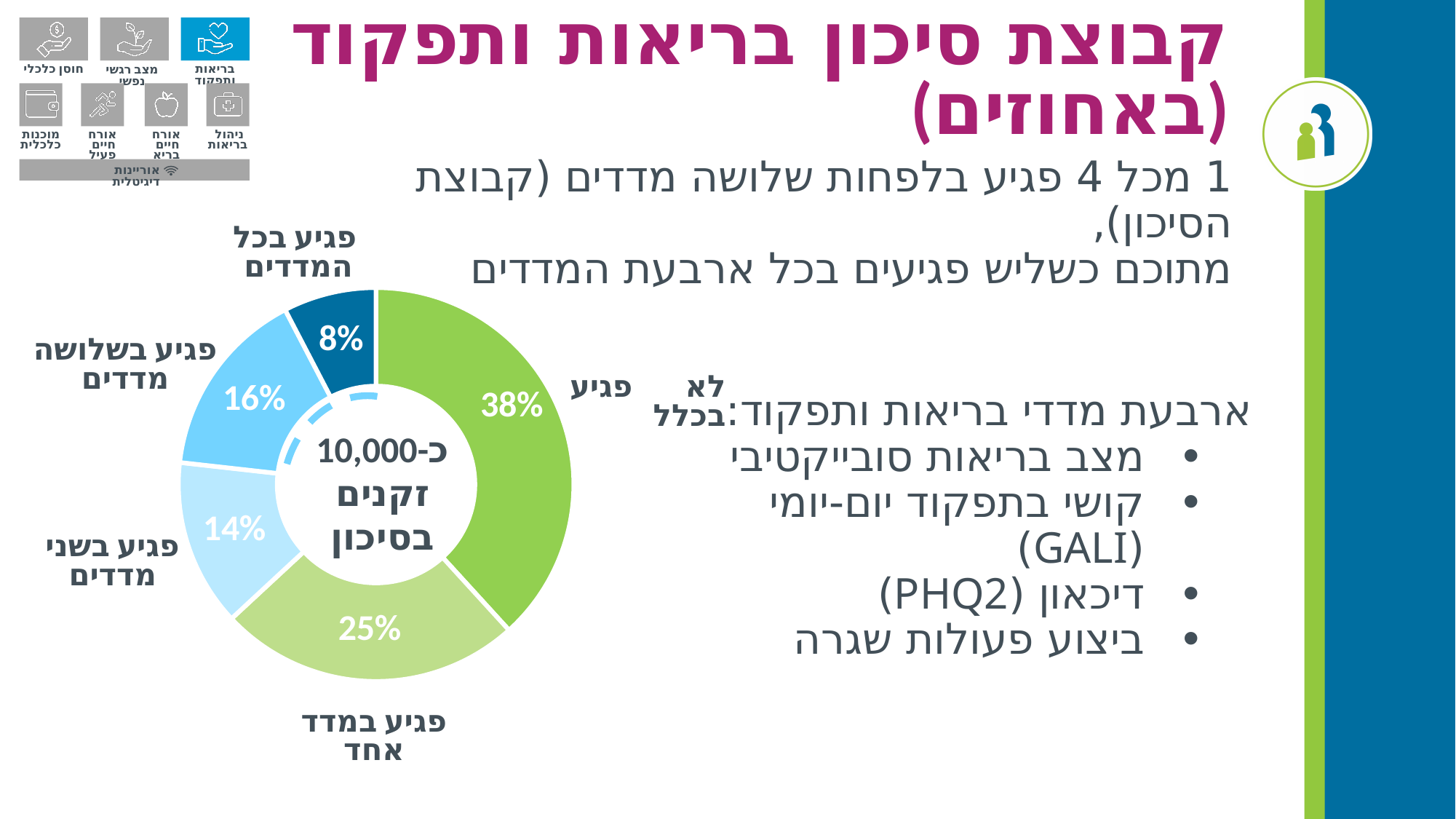
Which slice of the donut chart has the smallest share? פגיע בכל המדדים Which slice of the donut chart has the largest share? לא פגיע בכלל How many slices does the donut chart have? 5 What percentage is shown for the slice labelled "פגיע בשני מדדים"? 14% What kind of chart is shown on the slide? Donut (pie) chart What percentage is shown for the slice labelled "לא פגיע בכלל"? 38% What percentage is shown for the slice labelled "פגיע בכל המדדים"? 8% What is the difference in percentage points between "לא פגיע בכלל" and "פגיע במדד אחד"? 13 What text is written in the centre of the donut chart? כ-10,000 זקנים בסיכון Which is larger: the share for "פגיע בשלושה מדדים" or the share for "פגיע בשני מדדים"? פגיע בשלושה מדדים What percentage is shown for the slice labelled "פגיע במדד אחד"? 25% What percentage is shown for the slice labelled "פגיע בשלושה מדדים"? 16%